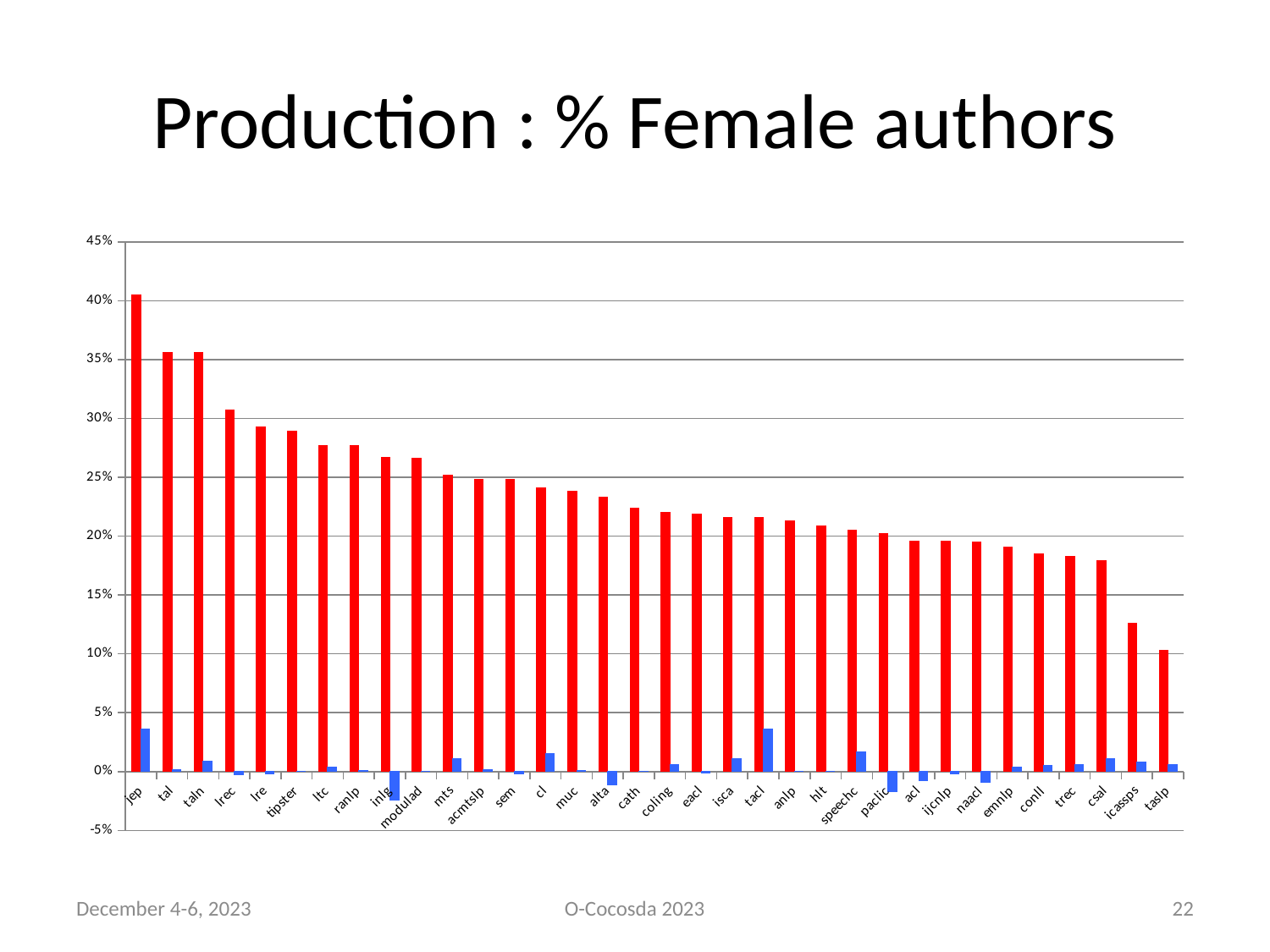
What two colours are used for the bars in the chart? red and blue Is the red bar for lrec greater or less than 30%? greater What is the title of the chart? Production : % Female authors Which has a taller red bar, tal or csal? tal Which category has the highest red bar? jep Do the red bars generally rise or fall from left to right along the x axis? fall How many categories are shown along the x axis? 34 Is the red bar for jep greater or less than 40%? greater Is the red bar for icassps greater or less than 15%? less Which category has the lowest red bar? taslp What kind of chart is shown on the slide? bar chart